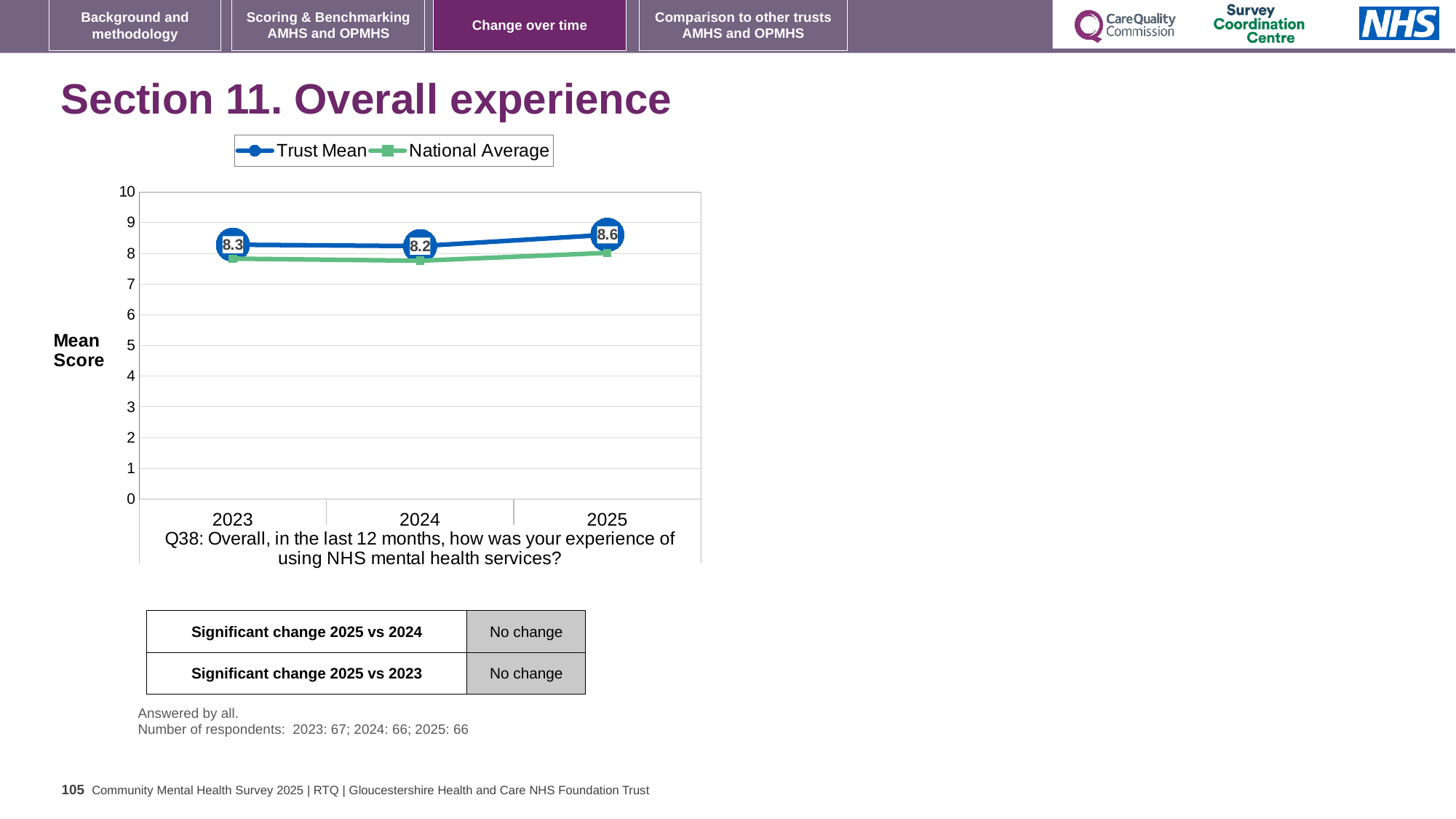
What is the Trust Mean score for 2023? 8.3 Is the National Average value for 2023 greater or less than 8? less What kind of chart is shown on the slide? Line chart Does the Trust Mean rise or fall from 2024 to 2025? Rise In which year is the Trust Mean score lowest? 2024 What is the Trust Mean score for 2024? 8.2 How many years are shown on the x axis of the chart? 3 In 2025, which is higher: the Trust Mean or the National Average? Trust Mean What is the difference between the Trust Mean score in 2025 and in 2024? 0.4 How many series does the chart legend list? 2 What is the Trust Mean score for 2025? 8.6 In which year is the Trust Mean score highest? 2025